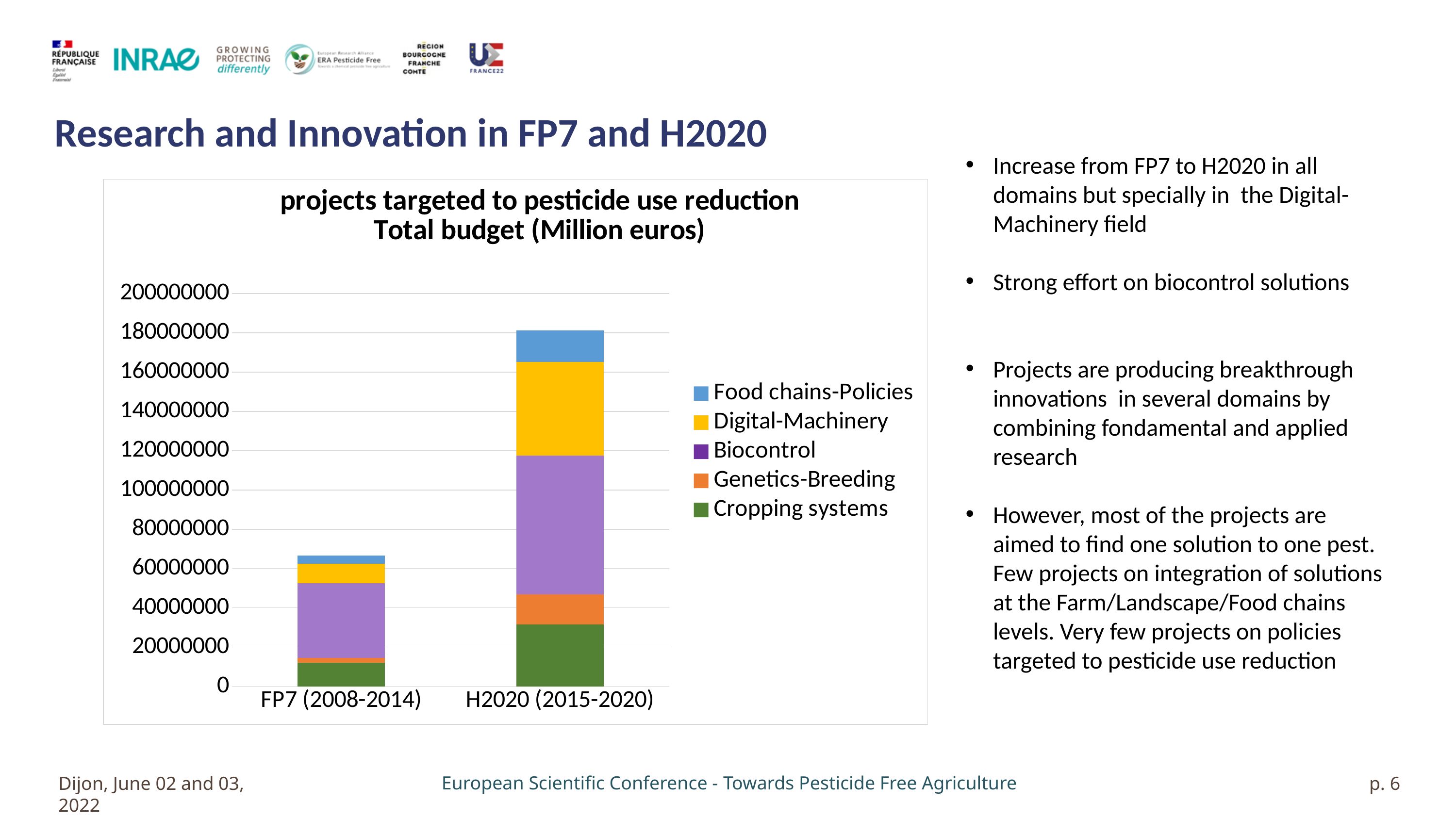
Is the total budget for H2020 (2015-2020) greater or less than 160000000? greater Is the total budget for FP7 (2008-2014) greater or less than 80000000? less Which series is shown in green in the legend? Cropping systems How many categories (bars) are plotted on the x axis? 2 Is the total budget for H2020 (2015-2020) greater or less than 200000000? less Which bar has the larger total budget, FP7 (2008-2014) or H2020 (2015-2020)? H2020 (2015-2020) Which series forms the largest segment of the H2020 (2015-2020) bar? Biocontrol What kind of chart is shown on the slide? Stacked bar chart What is the title of the chart? projects targeted to pesticide use reduction Total budget (Million euros) How many series does the legend list? 5 Does the total budget rise or fall from FP7 (2008-2014) to H2020 (2015-2020)? rise In which bar is the Digital-Machinery segment larger, FP7 (2008-2014) or H2020 (2015-2020)? H2020 (2015-2020)